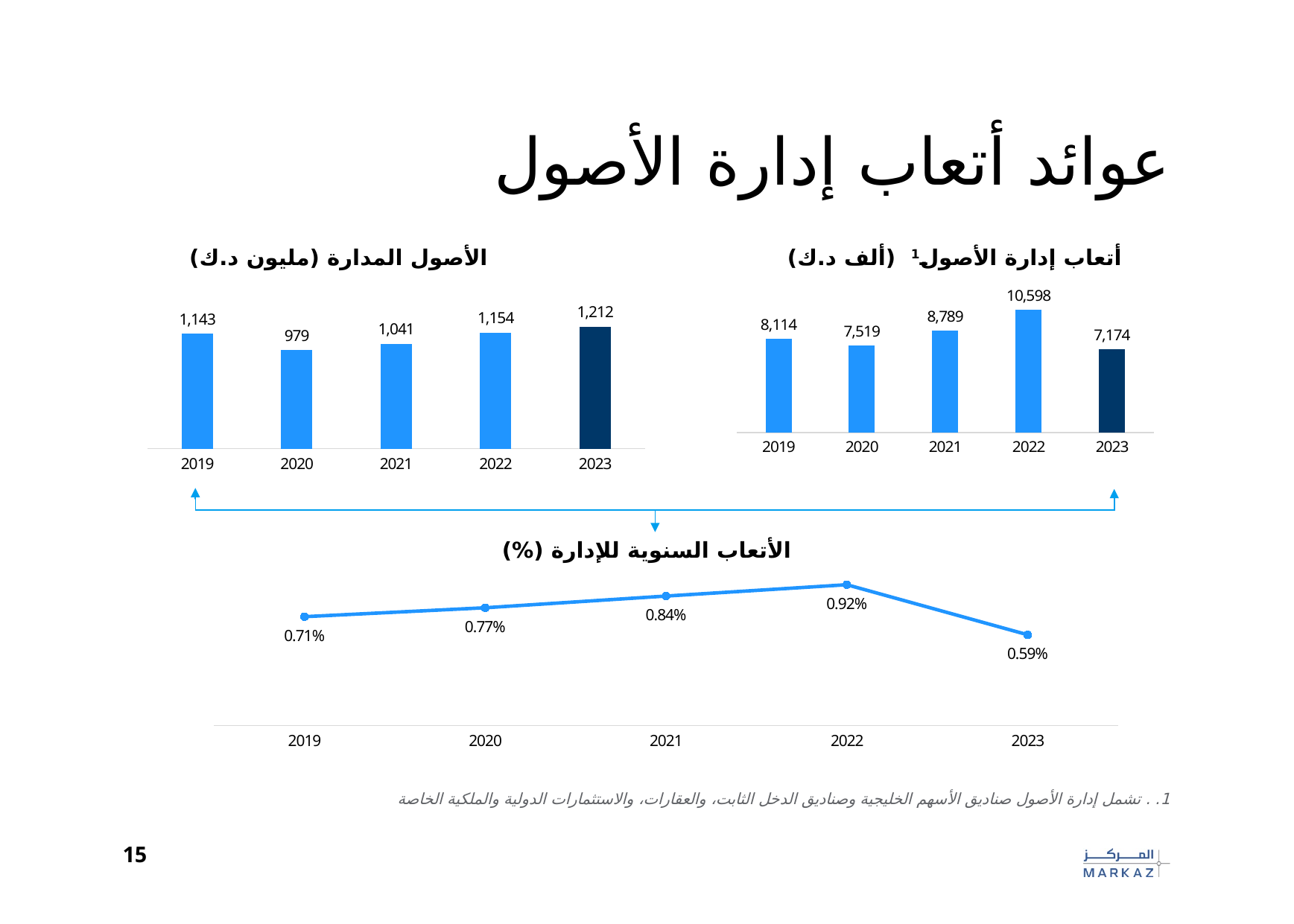
In the top-left chart (الأصول المدارة), which year has the highest value? 2023 In the bottom line chart (الأتعاب السنوية للإدارة), how do the values change from 2019 to 2022? They rise In the top-left chart (الأصول المدارة), what is the value for 2020? 979 In the bottom line chart (الأتعاب السنوية للإدارة), what is the value for 2021? 0.84% In the top-left chart (الأصول المدارة), what is the difference between the 2023 and 2022 values? 58 How many years are shown on the x axis of the bottom line chart? 5 In the bottom line chart (الأتعاب السنوية للإدارة), which year has the highest value? 2022 What type of chart is the bottom chart (الأتعاب السنوية للإدارة)? Line chart In the top-left chart (الأصول المدارة), which is larger, the value for 2019 or the value for 2021? 2019 In the top-right chart (أتعاب إدارة الأصول), which year has the lowest value? 2023 In the top-right chart (أتعاب إدارة الأصول), what is the difference between the 2022 and 2023 values? 3,424 In the top-right chart (أتعاب إدارة الأصول), what is the value for 2022? 10,598